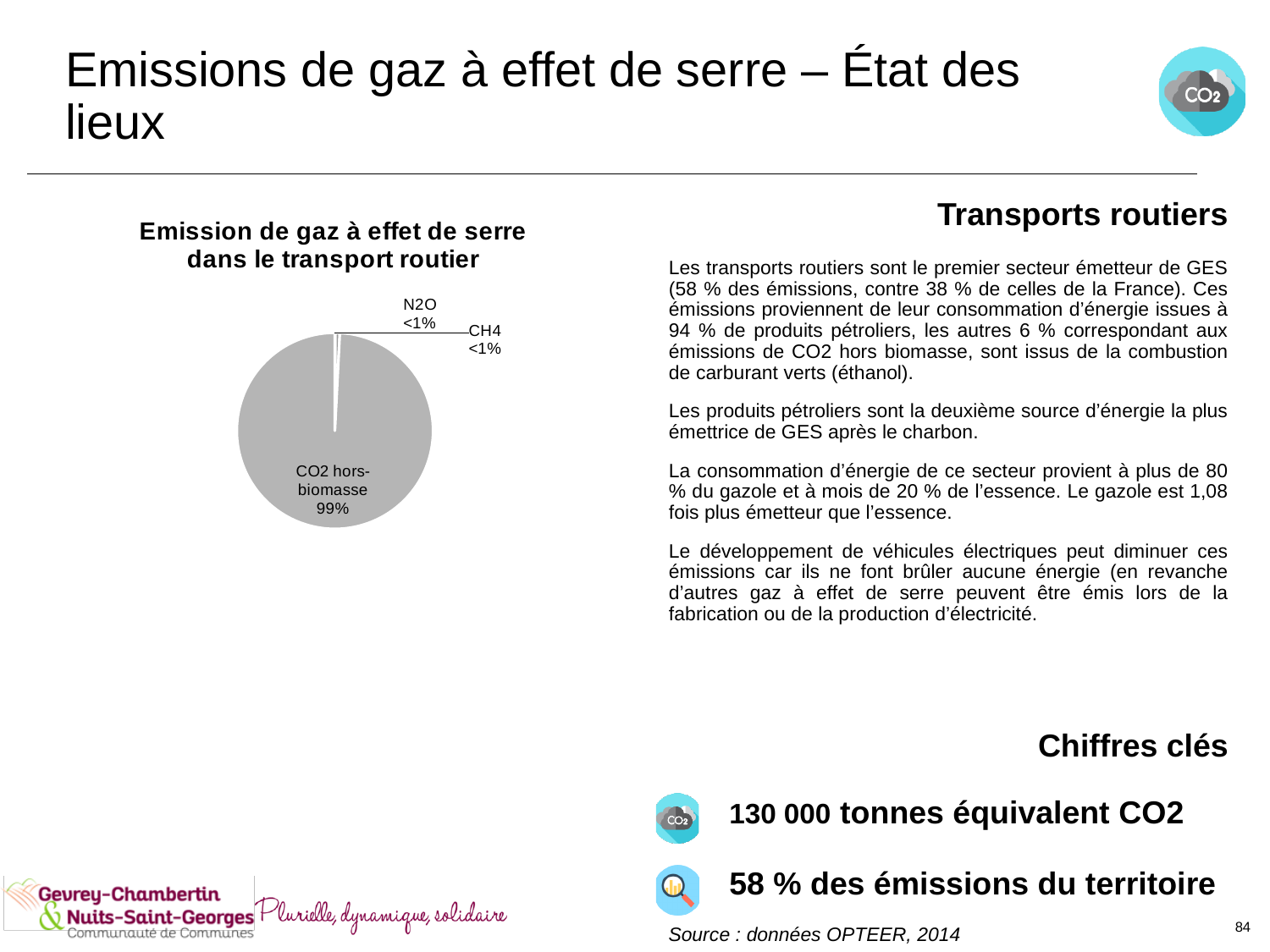
What value is shown for CH4 in the pie chart? <1% Which is larger in the pie chart, CO2 hors-biomasse or CH4? CO2 hors-biomasse Which is larger in the pie chart, N2O or CO2 hors-biomasse? CO2 hors-biomasse What colour is the CO2 hors-biomasse slice of the pie chart? grey How many slices does the pie chart have? 3 Which category has the largest slice in the pie chart? CO2 hors-biomasse What value is shown for N2O in the pie chart? <1% What share of the pie does CO2 hors-biomasse represent? 99% What kind of chart is shown on the slide? pie chart What is the title of the chart? Emission de gaz à effet de serre dans le transport routier